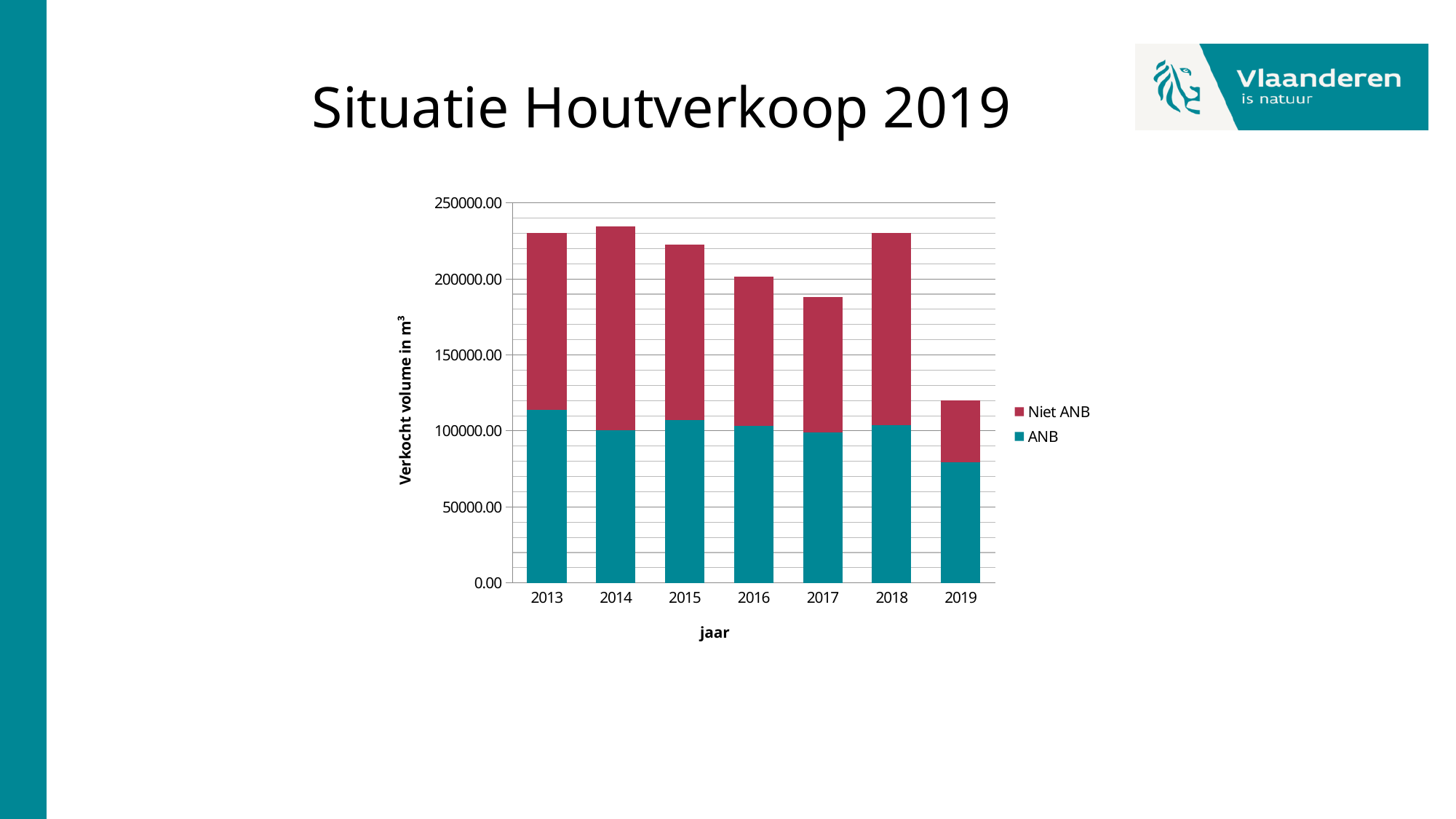
Which year has the lowest total sold volume? 2019 Do the total sold volumes rise or fall from 2014 to 2017? fall Is the total sold volume for 2017 greater or less than 200000.00? less Is the total sold volume for 2013 greater or less than 200000.00? greater Is the ANB sold volume for 2019 greater or less than 100000.00? less How many series does the chart legend list? 2 How many years are shown on the x axis of the chart? 7 What kind of chart is shown on the slide? bar chart Which year has the lowest ANB sold volume? 2019 Is the total sold volume larger in 2018 or in 2017? 2018 Which year has the highest ANB sold volume? 2013